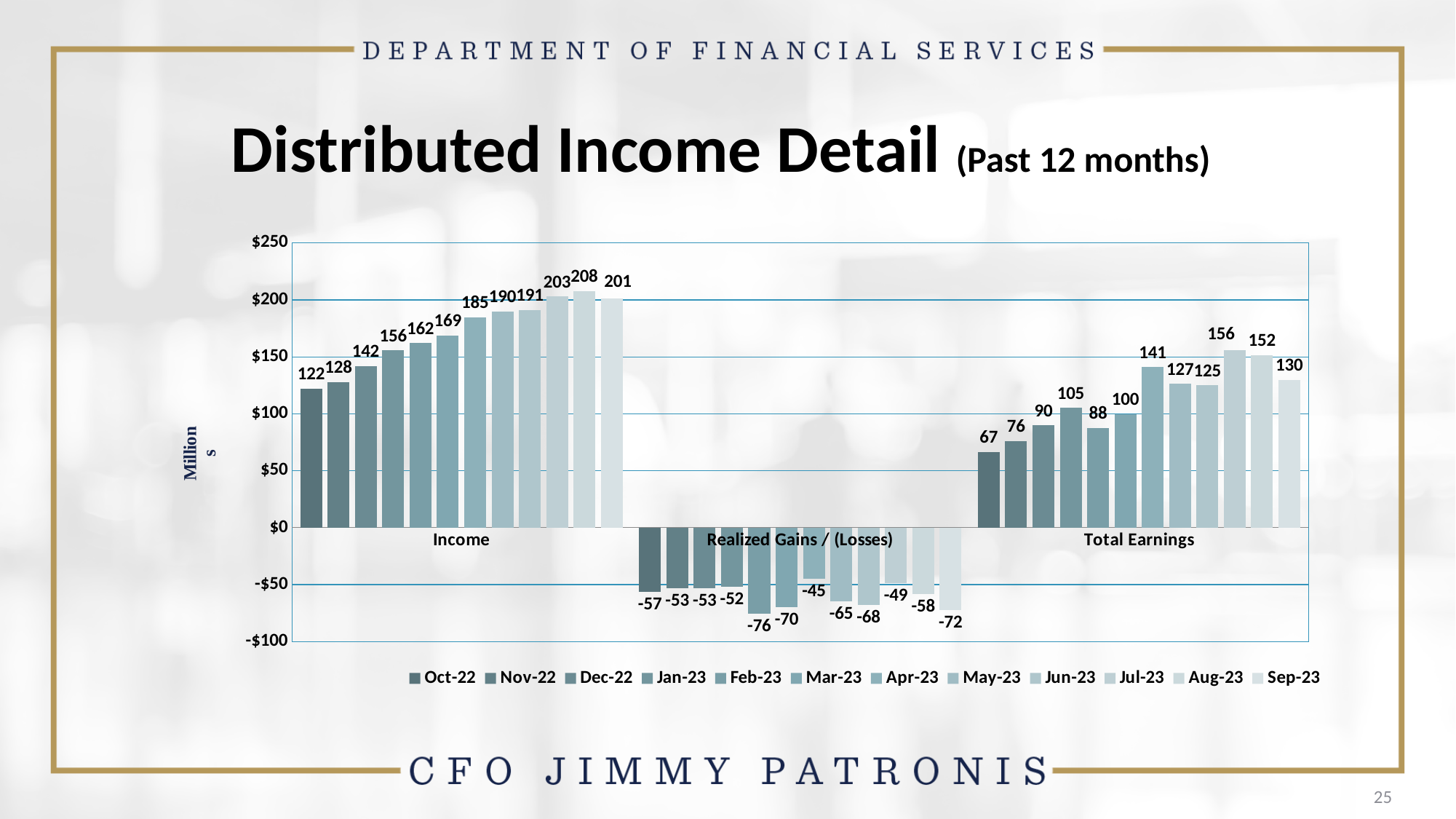
What is the Total Earnings value for Oct-22? 67 What is the title of the slide's chart? Distributed Income Detail (Past 12 months) What is the Income value for Sep-23? 201 How many series does the legend list? 12 How many categories are shown on the x axis? 3 Which month has the highest Income value? Aug-23 What is the Realized Gains / (Losses) value for Feb-23? -76 Which month has the lowest Total Earnings value? Oct-22 What is the difference between the Income values for Aug-23 and Oct-22? 86 What kind of chart is shown on the slide? Bar chart Do the Income values rise or fall from Oct-22 to Jul-23? Rise Which is larger, the Total Earnings value for Jul-23 or for Aug-23? Jul-23